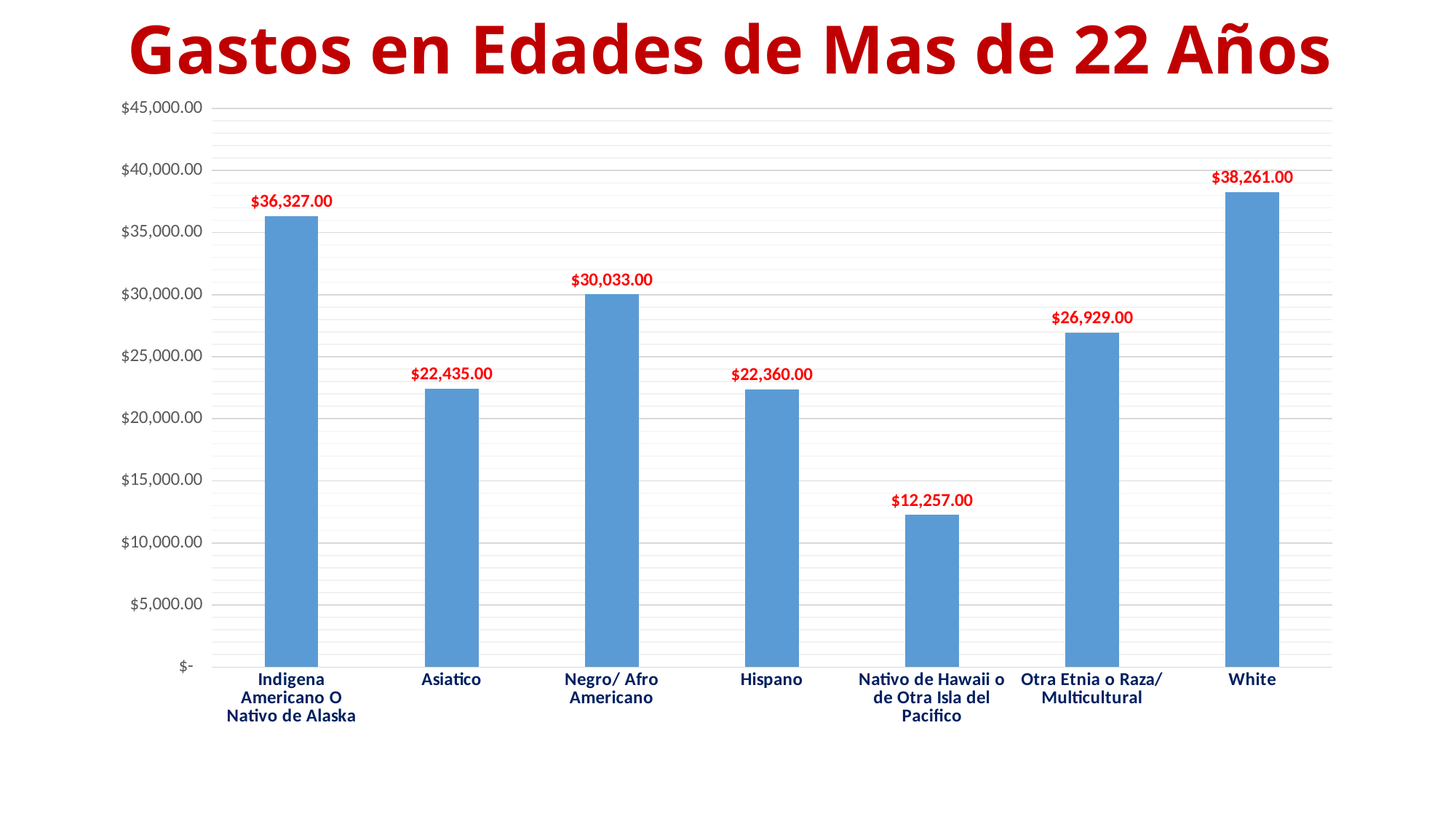
Which is larger, the value for Otra Etnia o Raza/ Multicultural or the value for Asiatico? Otra Etnia o Raza/ Multicultural What is the difference between the values for Negro/ Afro Americano and Hispano? $7,673.00 How many categories are shown on the chart? 7 What is the title of the chart? Gastos en Edades de Mas de 22 Años What is the difference between the values for White and Indigena Americano O Nativo de Alaska? $1,934.00 Is the value for Otra Etnia o Raza/ Multicultural greater or less than $25,000.00? greater Which category has the highest value? White What is the value for Nativo de Hawaii o de Otra Isla del Pacifico? $12,257.00 What is the value for Negro/ Afro Americano? $30,033.00 What kind of chart is shown on the slide? bar chart Which category has the lowest value? Nativo de Hawaii o de Otra Isla del Pacifico What is the value for White? $38,261.00